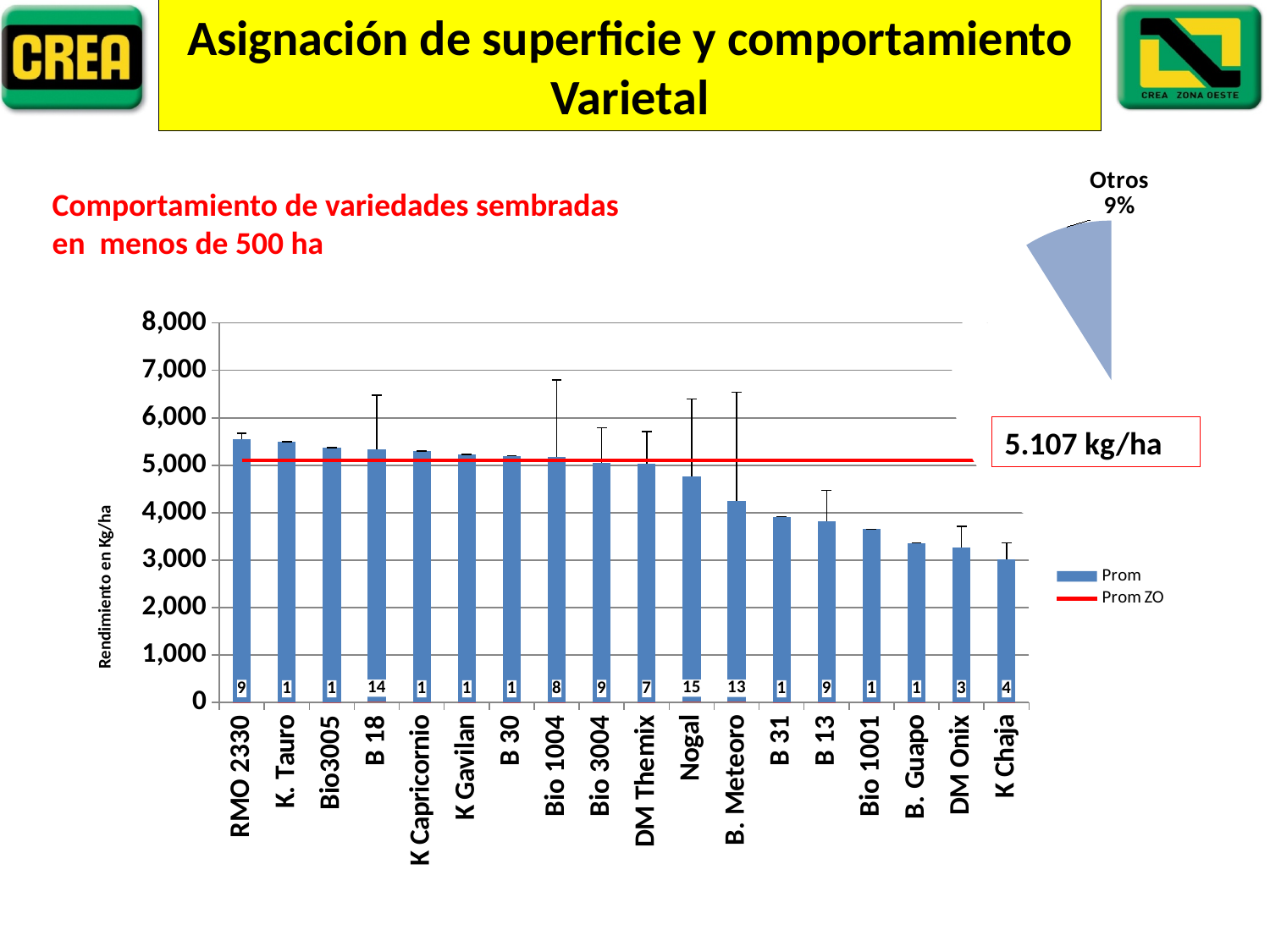
Is the Prom value for K Chaja greater or less than 4,000? less What value is labelled for the red Prom ZO line? 5.107 kg/ha What number is printed at the base of the Nogal bar? 15 Is the Prom value for RMO 2330 greater or less than 5,000? greater Which variety has the lowest Prom value in the bar chart? K Chaja Is the Prom value for Nogal greater or less than 5,000? less How many series does the legend of the bar chart list? 2 What kind of chart is the main chart on the slide? bar chart Do the Prom values rise or fall from left to right along the x axis? fall Which variety has the highest Prom value in the bar chart? RMO 2330 What share does the 'Otros' slice represent in the pie chart at the top right? 9% How many varieties are shown on the x axis of the bar chart? 18